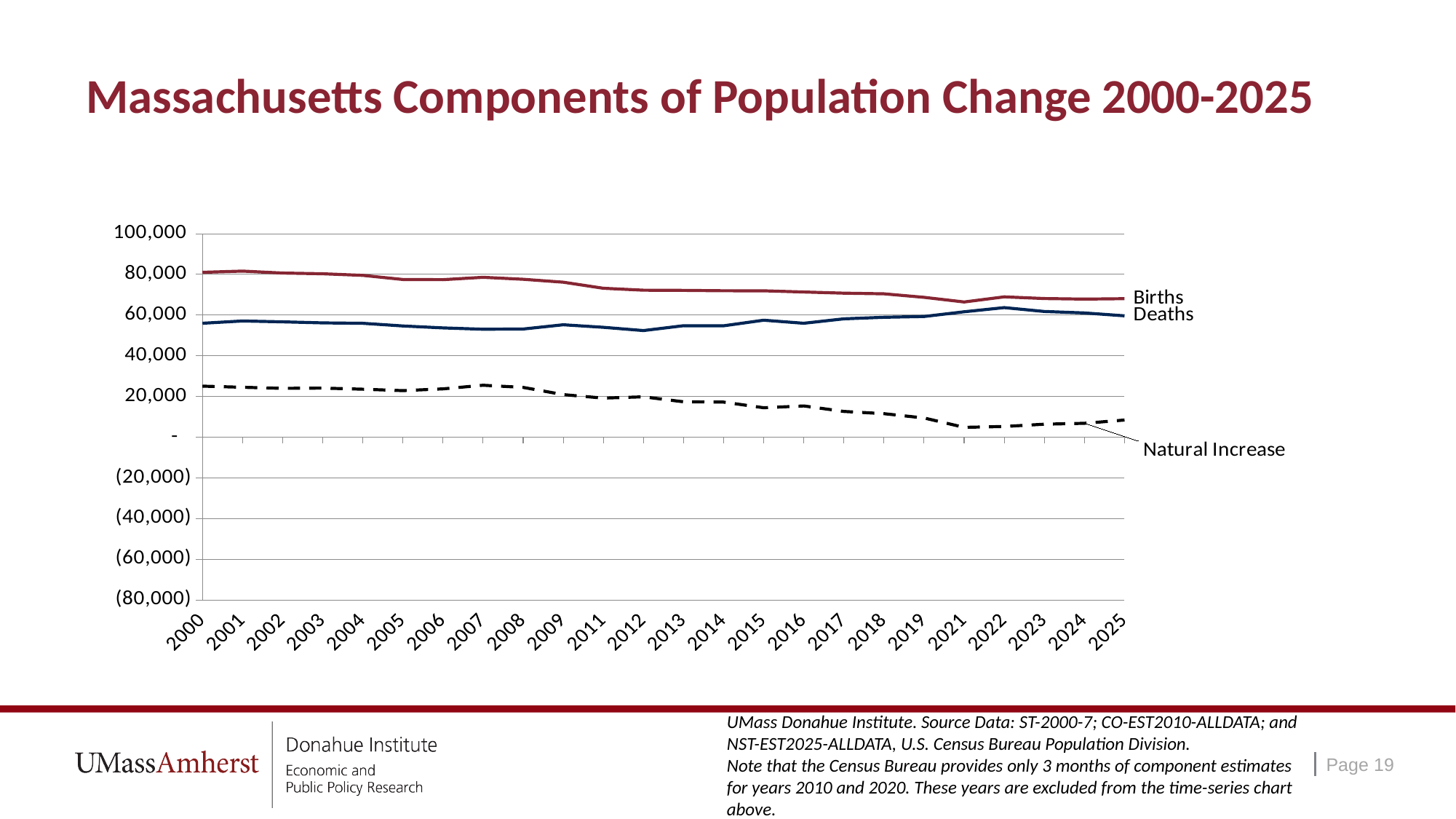
Which series has the lowest values across the chart? Natural Increase In 2000, which is larger, Births or Deaths? Births How many years are shown on the x axis of the chart? 24 Which series is drawn with a dashed line? Natural Increase Which series has the highest values across the chart? Births Do the Births values generally rise or fall from 2000 to 2025? fall Do the Natural Increase values generally rise or fall from 2000 to 2025? fall Is the value for Natural Increase in 2021 greater or less than 20,000? less What is the title of the chart? Massachusetts Components of Population Change 2000-2025 What kind of chart is shown on the slide? line chart Is the value for Births in 2025 greater or less than 80,000? less How many series are plotted on the chart? 3